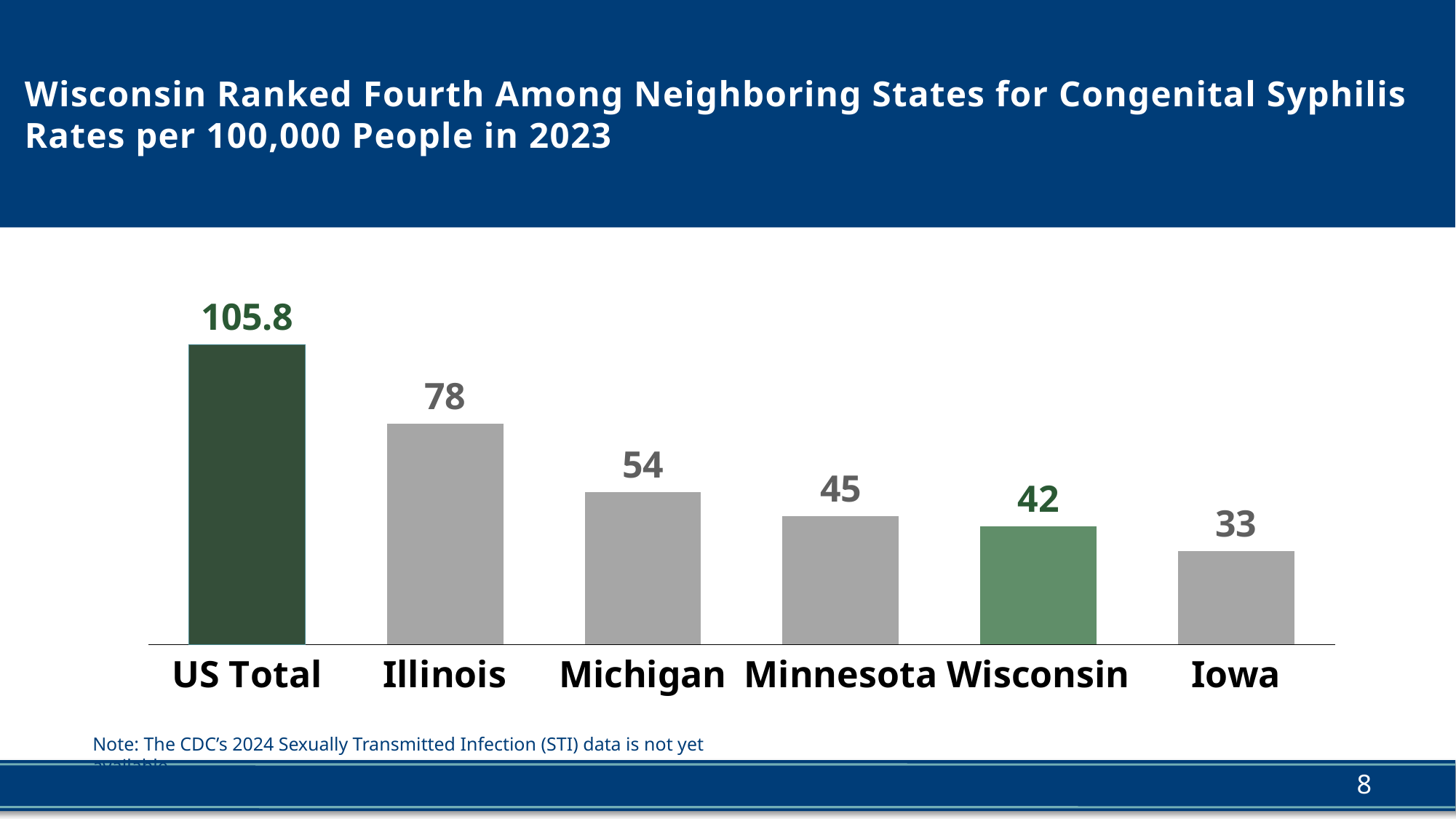
How many bars are shown in the chart? 6 What kind of chart is shown on the slide? Bar chart Which has a larger value, Michigan or Minnesota? Michigan Which category has the highest value in the chart? US Total What is the value shown for Illinois? 78 What is the difference between the values for Wisconsin and Iowa? 9 Which state has the lowest value in the chart? Iowa What is the value shown for Minnesota? 45 What is the congenital syphilis rate shown for Wisconsin? 42 What is the difference between the values for Illinois and Michigan? 24 What value is shown for the US Total bar? 105.8 Do the values rise or fall from left to right across the chart? Fall